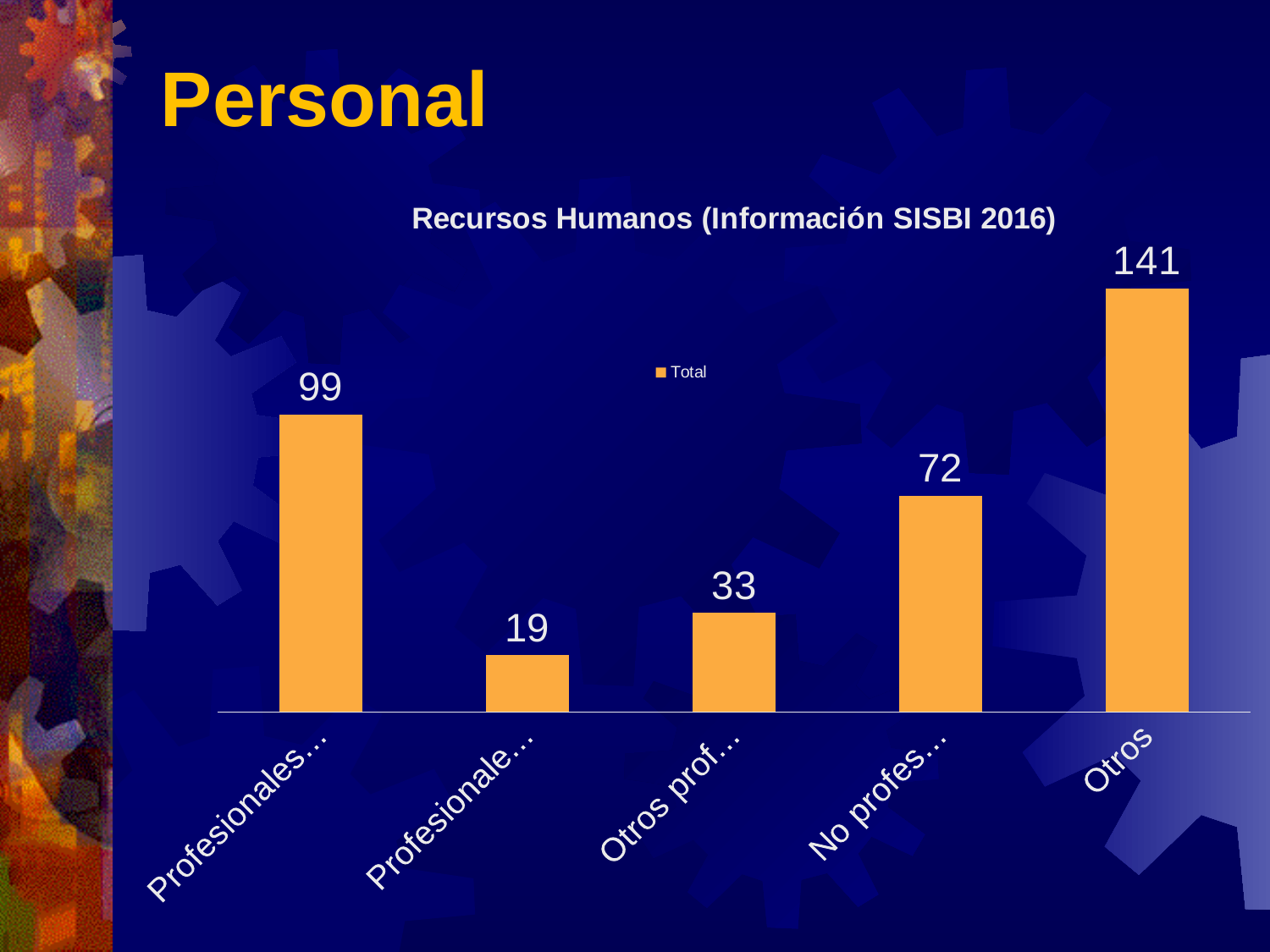
In the Recursos Humanos chart, is the third bar from the left (33) larger or smaller than the fourth bar (72)? smaller How many bars are plotted in the Recursos Humanos chart? 5 What is the lowest value shown in the Recursos Humanos chart? 19 What is the value of the fourth bar from the left in the Recursos Humanos chart? 72 What is the value of the second bar from the left in the Recursos Humanos chart? 19 How many series does the legend of the Recursos Humanos chart list? 1 Which category has the highest value in the Recursos Humanos chart? Otros What is the value of the first (leftmost) bar in the Recursos Humanos chart? 99 What is the name of the series shown in the legend of the Recursos Humanos chart? Total What kind of chart is shown under the title "Recursos Humanos (Información SISBI 2016)"? bar chart What is the value of the "Otros" bar in the Recursos Humanos chart? 141 What is the difference between the "Otros" bar and the first bar in the Recursos Humanos chart? 42